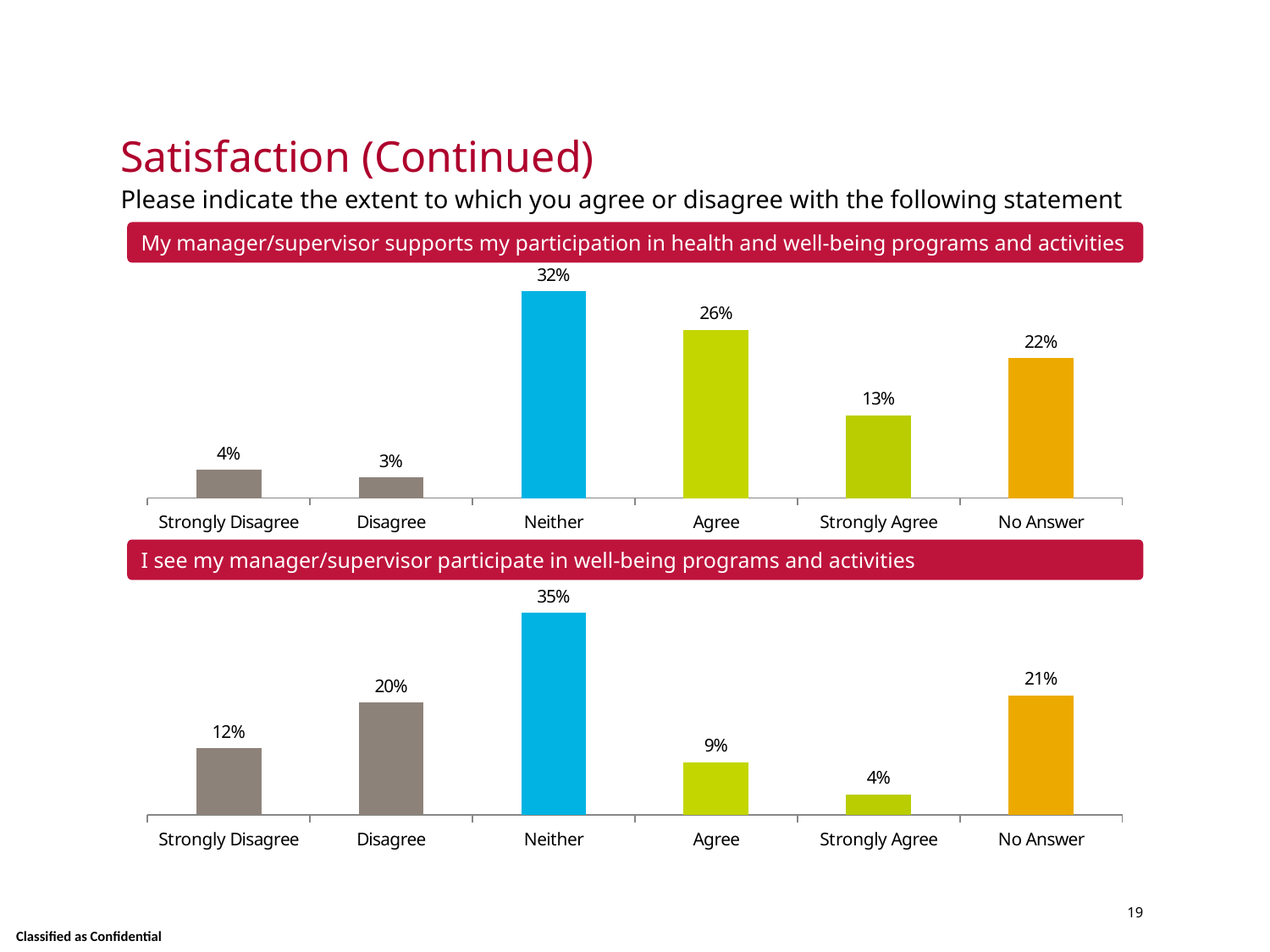
In the bottom chart ('I see my manager/supervisor participate...'), which category has the lowest value? Strongly Agree In the top chart ('My manager/supervisor supports my participation...'), what is the difference between Agree and Strongly Agree? 13% In the top chart ('My manager/supervisor supports my participation...'), what is the value for Strongly Agree? 13% How many categories are shown in the bottom chart ('I see my manager/supervisor participate...')? 6 In the top chart ('My manager/supervisor supports my participation in health and well-being programs and activities'), what is the value for Neither? 32% In the bottom chart ('I see my manager/supervisor participate in well-being programs and activities'), what is the value for Disagree? 20% What type of chart is the top chart ('My manager/supervisor supports my participation...')? Bar chart In the bottom chart ('I see my manager/supervisor participate...'), what is the value for No Answer? 21% In the bottom chart ('I see my manager/supervisor participate...'), which category has the highest value? Neither In the bottom chart ('I see my manager/supervisor participate...'), what is the difference between Neither and Agree? 26% In the top chart ('My manager/supervisor supports my participation...'), which category has the lowest value? Disagree In the top chart ('My manager/supervisor supports my participation...'), which is larger, Agree or No Answer? Agree